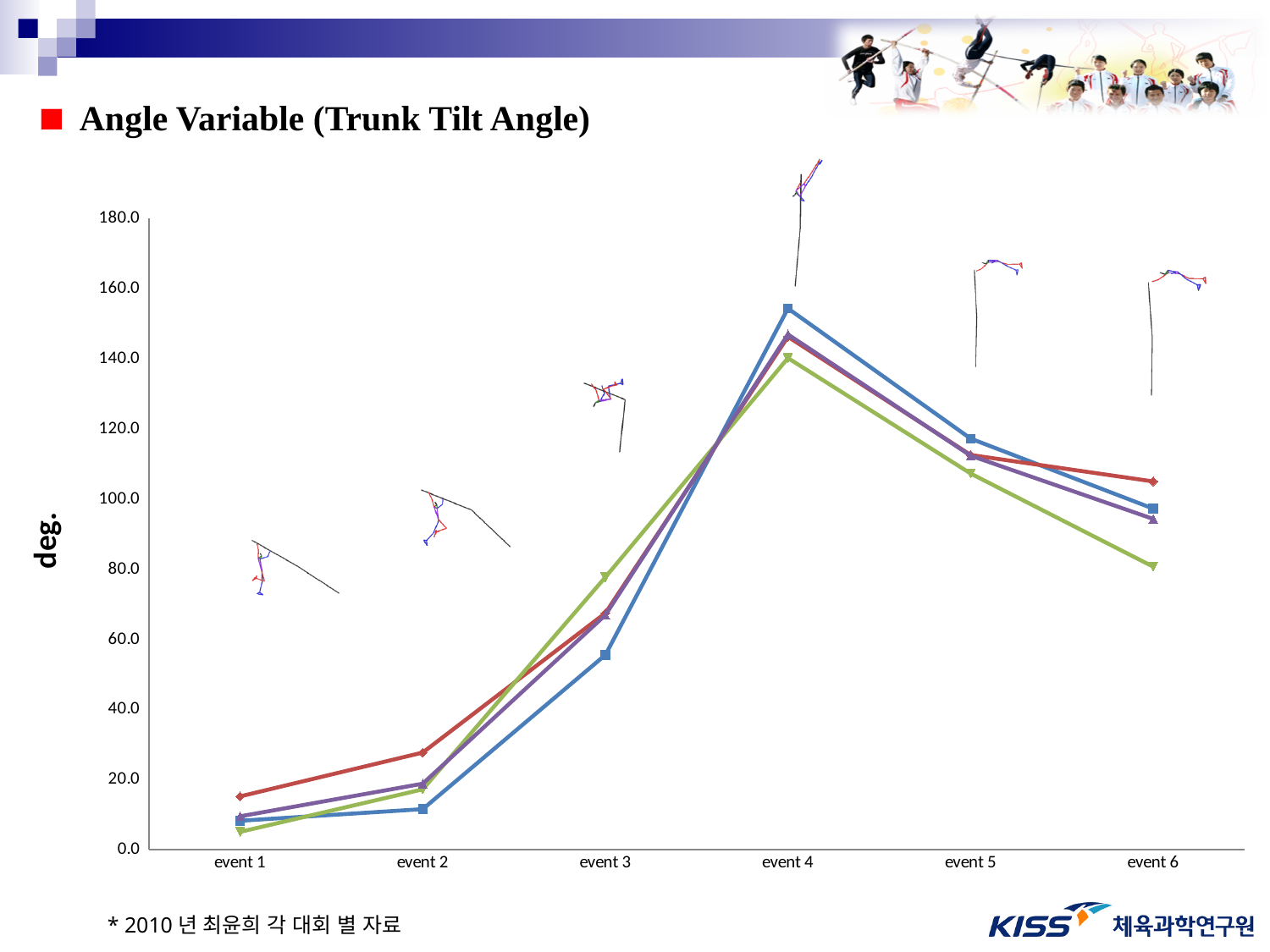
How many events are shown along the x axis of the chart? 6 Is the value of the blue line at event 3 greater or less than 40? greater At which event does the blue line reach its highest value? event 4 At event 2, which line has the larger value, the red line or the blue line? red line Is the value of the red line at event 1 greater or less than 20? less What is the label on the y axis of the chart? deg. Does the blue line rise or fall from event 1 to event 4? rise Is the value of the blue line at event 4 greater or less than 140? greater What kind of chart is shown on the slide? line chart At event 6, which line has the larger value, the blue line or the green line? blue line Does the green line rise or fall from event 4 to event 6? fall